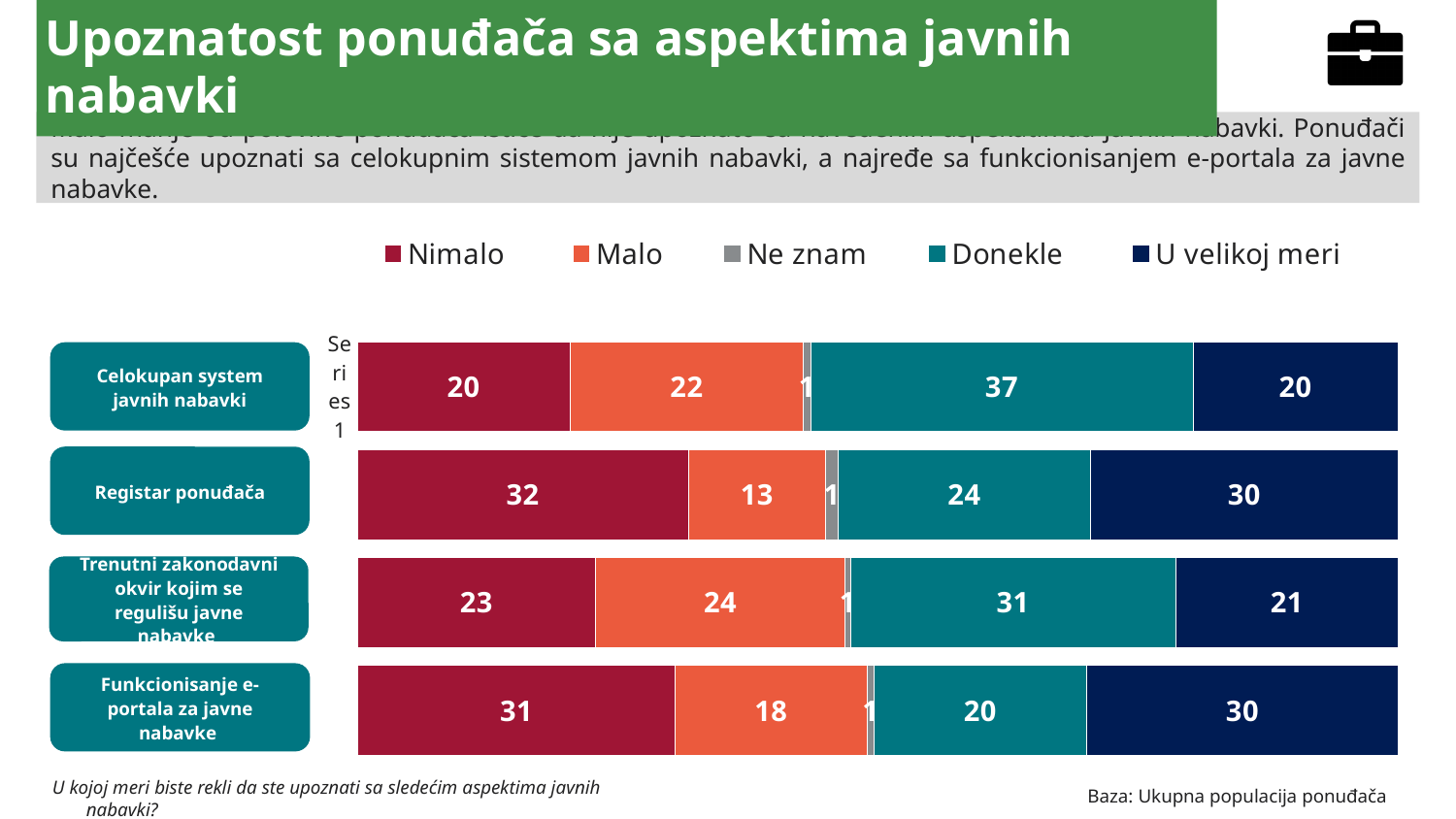
What is the value of 'U velikoj meri' for 'Funkcionisanje e-portala za javne nabavke'? 30 Which category has the highest 'Nimalo' value? Registar ponuđača Which category has the lowest 'Donekle' value? Funkcionisanje e-portala za javne nabavke What is the total of the stacked bar for 'Celokupan system javnih nabavki'? 100 How many categories (aspects of public procurement) are plotted in the chart? 4 How many series does the legend list? 5 What is the difference between the 'Nimalo' values for 'Registar ponuđača' and 'Celokupan system javnih nabavki'? 12 What is the value of 'Donekle' for 'Celokupan system javnih nabavki'? 37 What is the value of 'Nimalo' for 'Registar ponuđača'? 32 Which is larger: the 'U velikoj meri' value for 'Registar ponuđača' or for 'Trenutni zakonodavni okvir kojim se regulišu javne nabavke'? Registar ponuđača What kind of chart is shown on the slide? Stacked bar chart What is the value of 'Malo' for 'Trenutni zakonodavni okvir kojim se regulišu javne nabavke'? 24